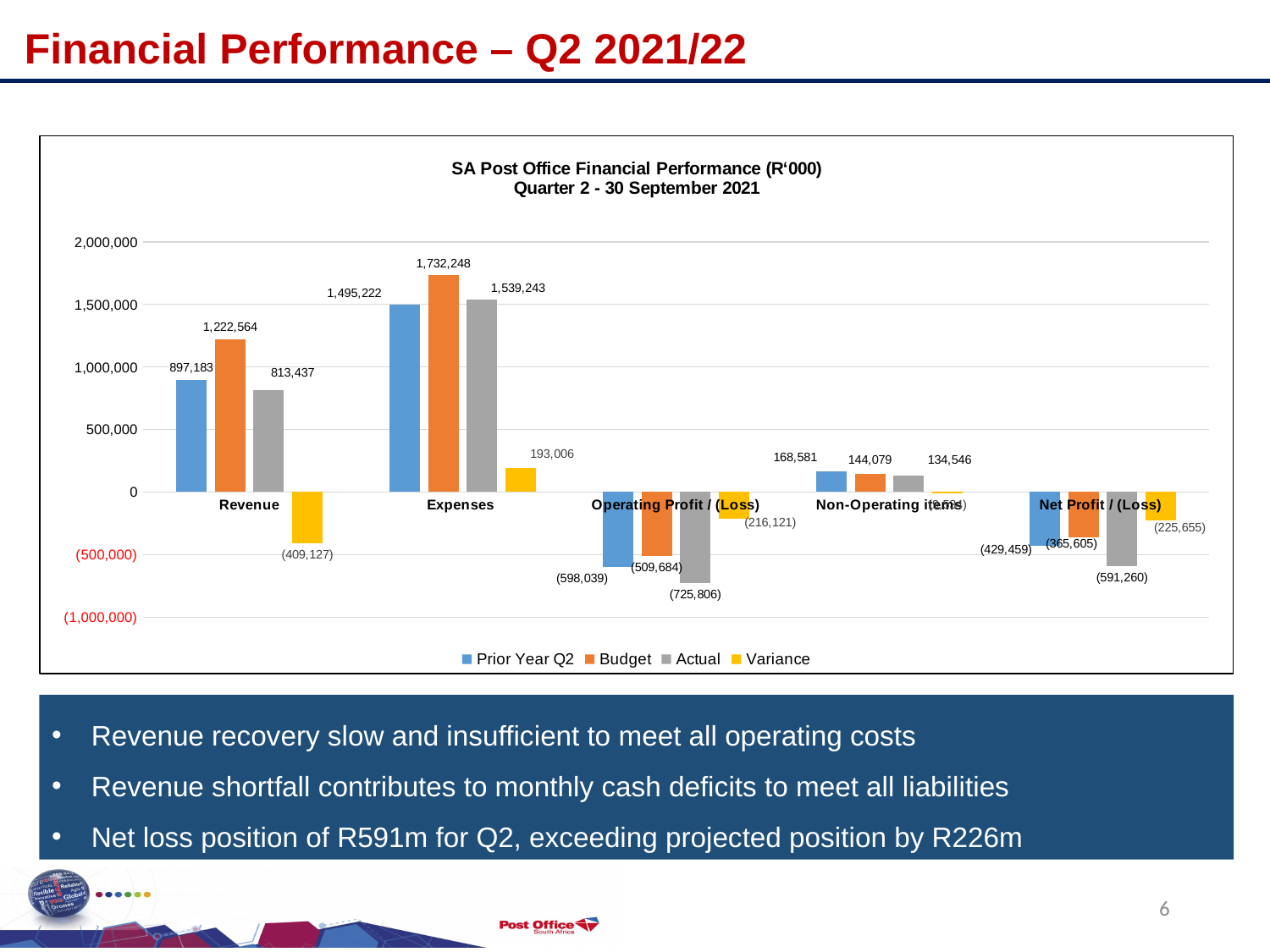
What is the Budget value for Expenses? 1,732,248 Is the Actual value for Expenses greater or less than 1,500,000? greater What is the difference between the Budget and Actual values for Revenue? 409,127 What is the difference between the Actual and Prior Year Q2 values for Expenses? 44,021 Which series has the highest value in the Expenses category? Budget Which is larger for Revenue: the Prior Year Q2 value or the Actual value? Prior Year Q2 What kind of chart is shown on the slide? bar chart What is the Actual value for Revenue? 813,437 Which category has the lowest Actual value? Operating Profit / (Loss) How many series does the legend list? 4 What is the Actual value for Net Profit / (Loss)? (591,260) How many categories are shown on the x axis? 5